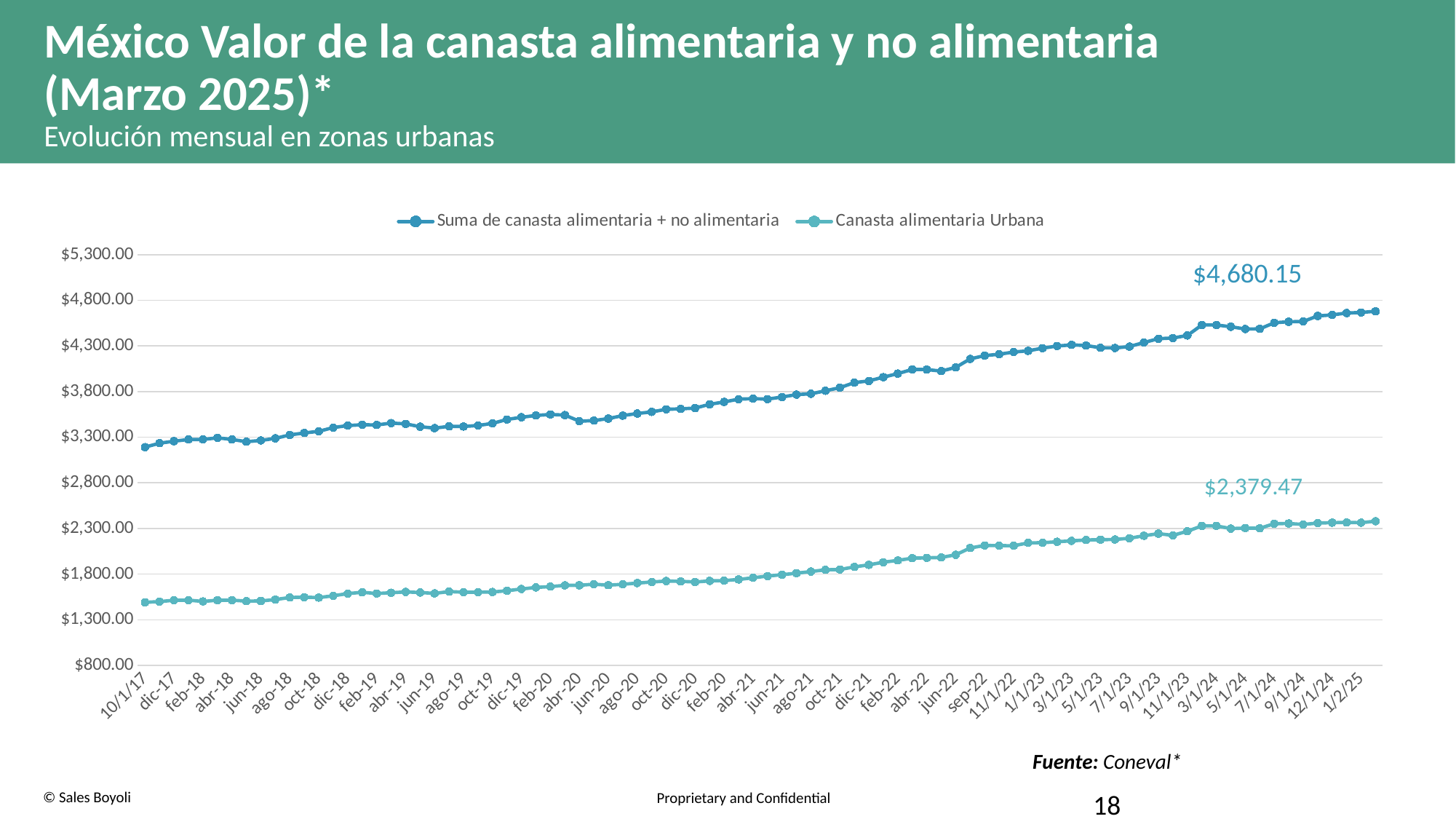
Is the value for 'Suma de canasta alimentaria + no alimentaria' at 10/1/17 greater or less than $3,800.00? less What is the subtitle shown under the main title of the slide? Evolución mensual en zonas urbanas What is the difference between the labelled values $4,680.15 and $2,379.47 shown on the chart? $2,300.68 How many series does the legend list? 2 What is the labelled value for the series 'Canasta alimentaria Urbana' at the end of the chart? $2,379.47 Is the value for 'Suma de canasta alimentaria + no alimentaria' at jun-22 greater or less than $4,300.00? less What kind of chart is shown on the slide? line chart Is the value for 'Canasta alimentaria Urbana' at 10/1/17 greater or less than $1,800.00? less What source is cited for the chart data? Coneval Do the values of the 'Suma de canasta alimentaria + no alimentaria' series generally rise or fall from 10/1/17 to 1/2/25? rise What is the labelled value for the series 'Suma de canasta alimentaria + no alimentaria' at the end of the chart? $4,680.15 Which series has the higher values throughout the chart? Suma de canasta alimentaria + no alimentaria